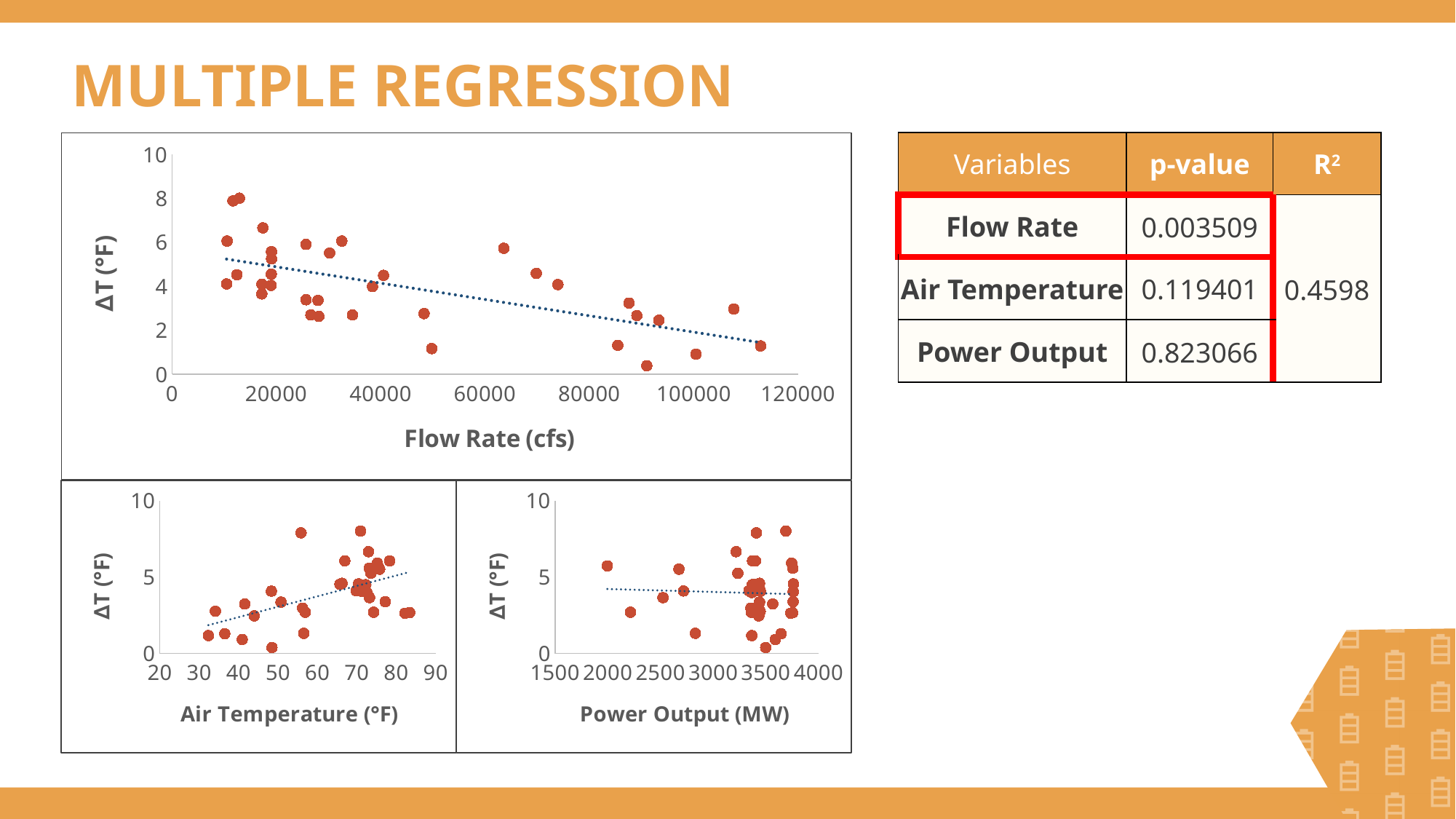
What is the minimum value shown on the x axis of the bottom-right chart? 1500 In the top chart, is the ΔT of the highest point greater or less than 6? greater What is the maximum value shown on the x axis of the top chart? 120000 What is the maximum value shown on the y axis of the bottom-left chart? 10 In the bottom-right chart, is the ΔT of the highest point greater or less than 5? greater In the top chart, does ΔT (°F) tend to rise or fall as Flow Rate (cfs) increases? fall How many charts are shown on the slide? 3 In the bottom-right chart, does the trend line rise steeply, fall steeply, or stay nearly flat as Power Output (MW) increases? nearly flat In the bottom-left chart, is the ΔT of the lowest point greater or less than 2? less What kind of chart is the top chart with Flow Rate (cfs) on the x axis? scatter chart In the bottom-left chart, does ΔT (°F) tend to rise or fall as Air Temperature (°F) increases? rise What is the x-axis label of the bottom-right chart? Power Output (MW)